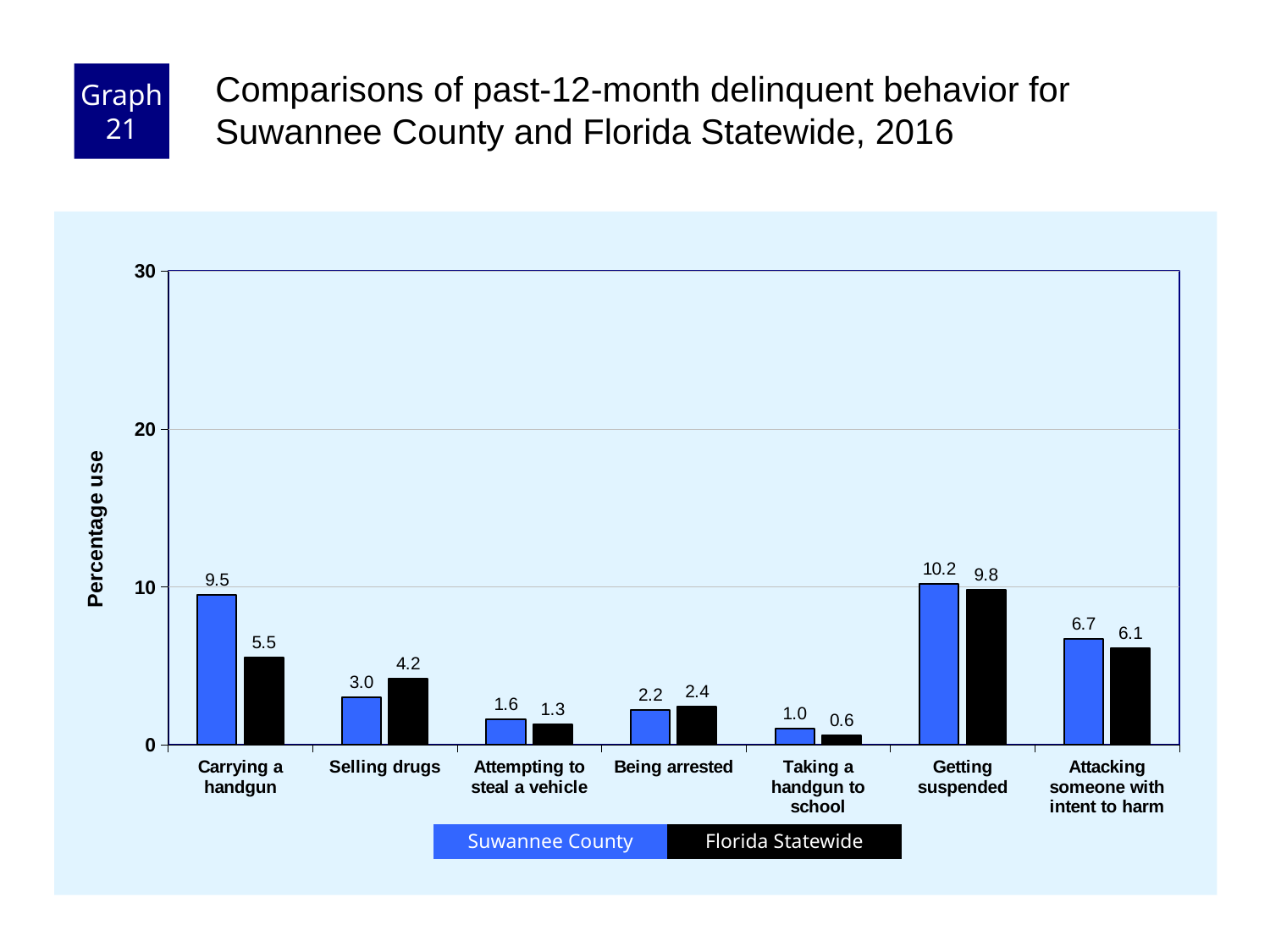
What is the difference between the Suwannee County and Florida Statewide values for Carrying a handgun? 4.0 What kind of chart is shown on the slide? Bar chart What is the Florida Statewide value for Selling drugs? 4.2 What is the Suwannee County value for Carrying a handgun? 9.5 Which category has the highest Suwannee County value? Getting suspended Is the Suwannee County value for Getting suspended greater or less than 10? greater What is the label of the y axis? Percentage use What is the Suwannee County value for Taking a handgun to school? 1.0 How many series does the legend list? 2 How many categories are shown on the x axis? 7 Which category has the lowest Florida Statewide value? Taking a handgun to school Which is larger for Being arrested: Suwannee County or Florida Statewide? Florida Statewide